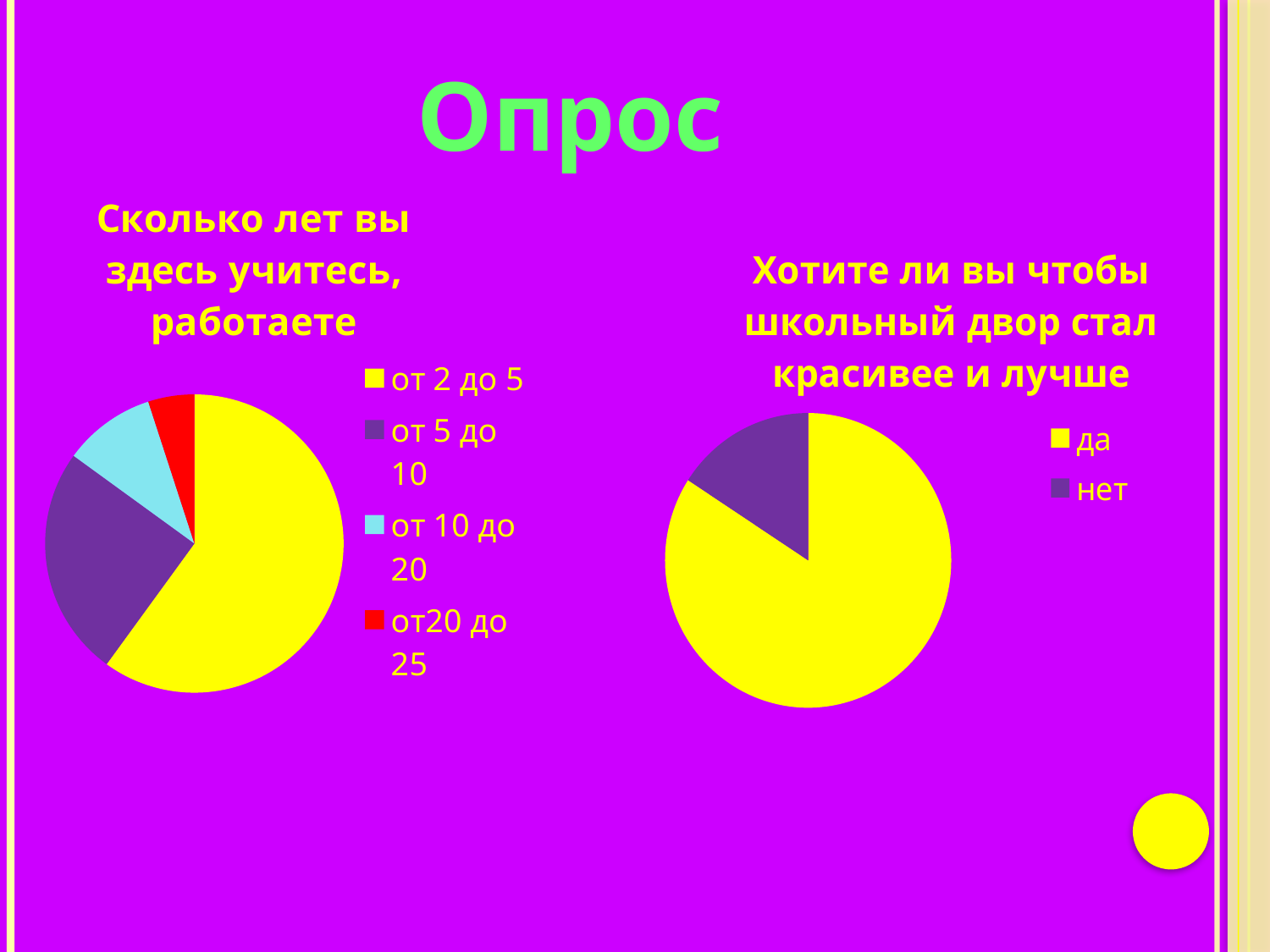
In the left chart "Сколько лет вы здесь учитесь, работаете", which category has the smallest slice? от20 до 25 In the right chart "Хотите ли вы чтобы школьный двор стал красивее и лучше", which answer has the larger slice? да In the right chart, what colour is the slice for "нет"? purple How many entries does the legend of the left chart "Сколько лет вы здесь учитесь, работаете" list? 4 In the right chart "Хотите ли вы чтобы школьный двор стал красивее и лучше", which slice is smaller: "да" or "нет"? нет In the left chart "Сколько лет вы здесь учитесь, работаете", which category has the largest slice? от 2 до 5 What kind of chart is the left chart titled "Сколько лет вы здесь учитесь, работаете"? pie chart What kind of chart is the right chart titled "Хотите ли вы чтобы школьный двор стал красивее и лучше"? pie chart In the left chart "Сколько лет вы здесь учитесь, работаете", how many slices does the pie have? 4 In the left chart "Сколько лет вы здесь учитесь, работаете", which slice is larger: "от 5 до 10" or "от 10 до 20"? от 5 до 10 In the right chart "Хотите ли вы чтобы школьный двор стал красивее и лучше", how many slices does the pie have? 2 In the left chart "Сколько лет вы здесь учитесь, работаете", what colour is the slice for "от 10 до 20"? light blue